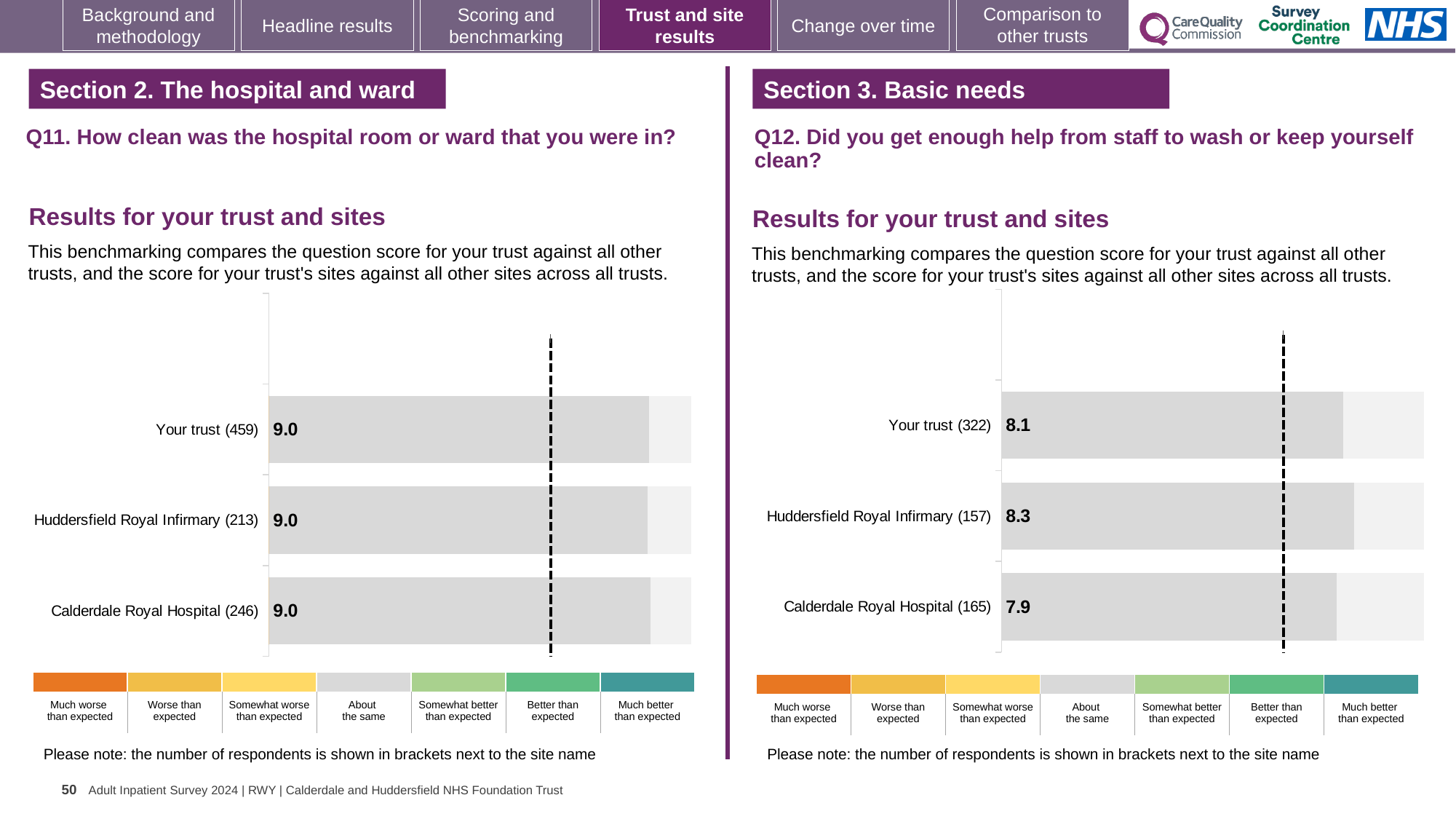
On the Q11 chart (left), what is the score for Your trust? 9.0 What kind of chart is the Q12 chart (right)? Bar chart How many bars are plotted on the Q11 chart (left)? 3 On the Q12 chart (right), which site or trust has the highest score? Huddersfield Royal Infirmary On the Q12 chart (right), what is the difference between the scores for Huddersfield Royal Infirmary and Calderdale Royal Hospital? 0.4 On the Q12 chart (right), what is the score for Huddersfield Royal Infirmary? 8.3 On the Q11 chart (left), how many respondents are shown in brackets for Your trust? 459 On the Q12 chart (right), what is the score for Your trust? 8.1 On the Q12 chart (right), what is the score for Calderdale Royal Hospital? 7.9 On the Q12 chart (right), which has the larger score, Your trust or Huddersfield Royal Infirmary? Huddersfield Royal Infirmary On the Q12 chart (right), which site or trust has the lowest score? Calderdale Royal Hospital On the Q11 chart (left), what is the score for Calderdale Royal Hospital? 9.0